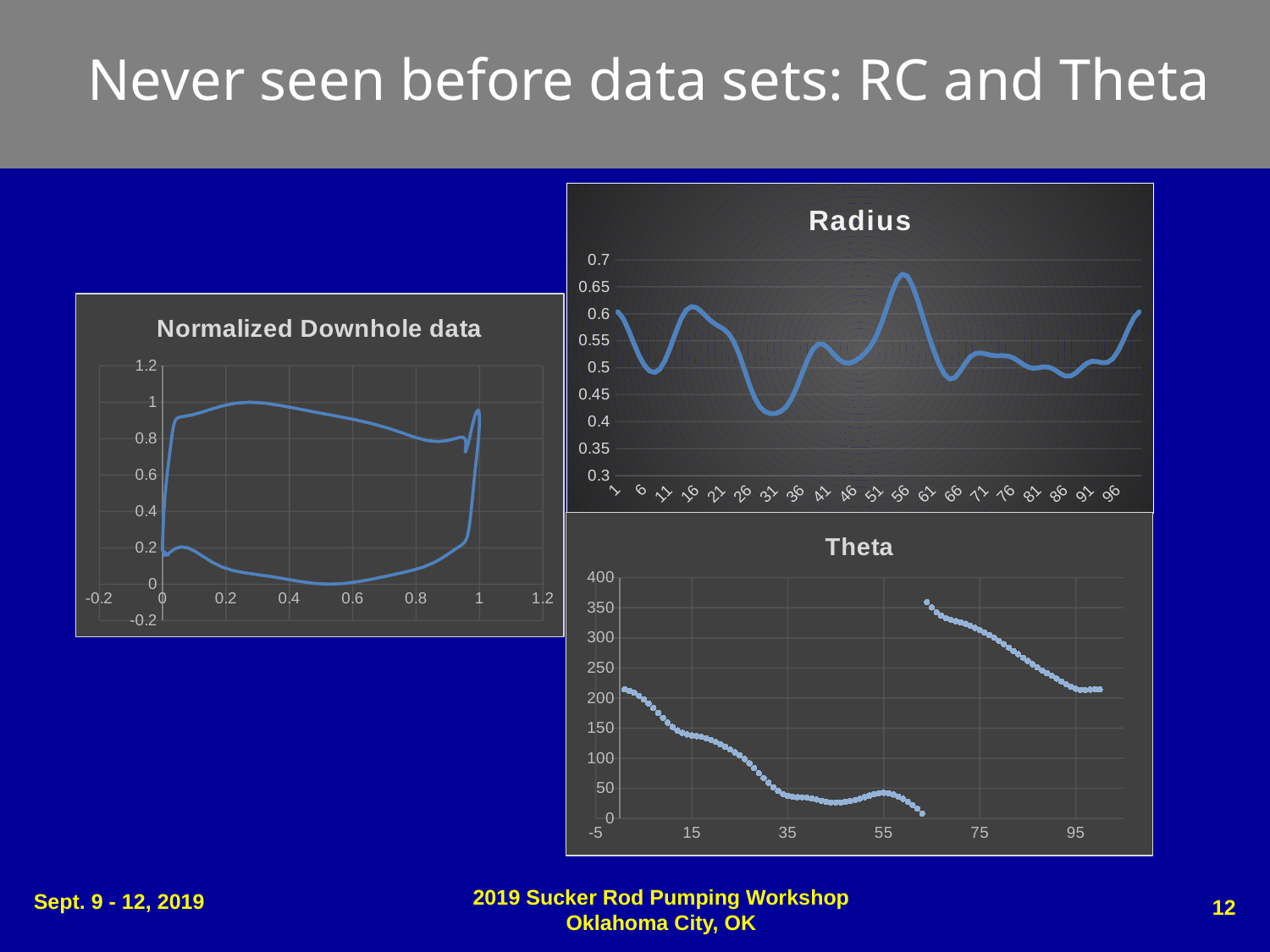
What is the title of the chart on the left side of the slide? Normalized Downhole data In the Theta chart, is the value at x = 15 greater or less than 100? greater What kind of chart is the Radius chart? line chart In the Theta chart, is the value at x = 95 greater or less than 250? less What kind of chart is the Theta chart? scatter chart How many charts are shown on the slide? 3 In the Theta chart, do the values rise or fall as x goes from 75 to 95? fall In the Radius chart, is the value at category 31 greater or less than 0.45? less In the Theta chart, what is the highest value shown on the vertical axis? 400 In the Radius chart, what is the highest value shown on the vertical axis? 0.7